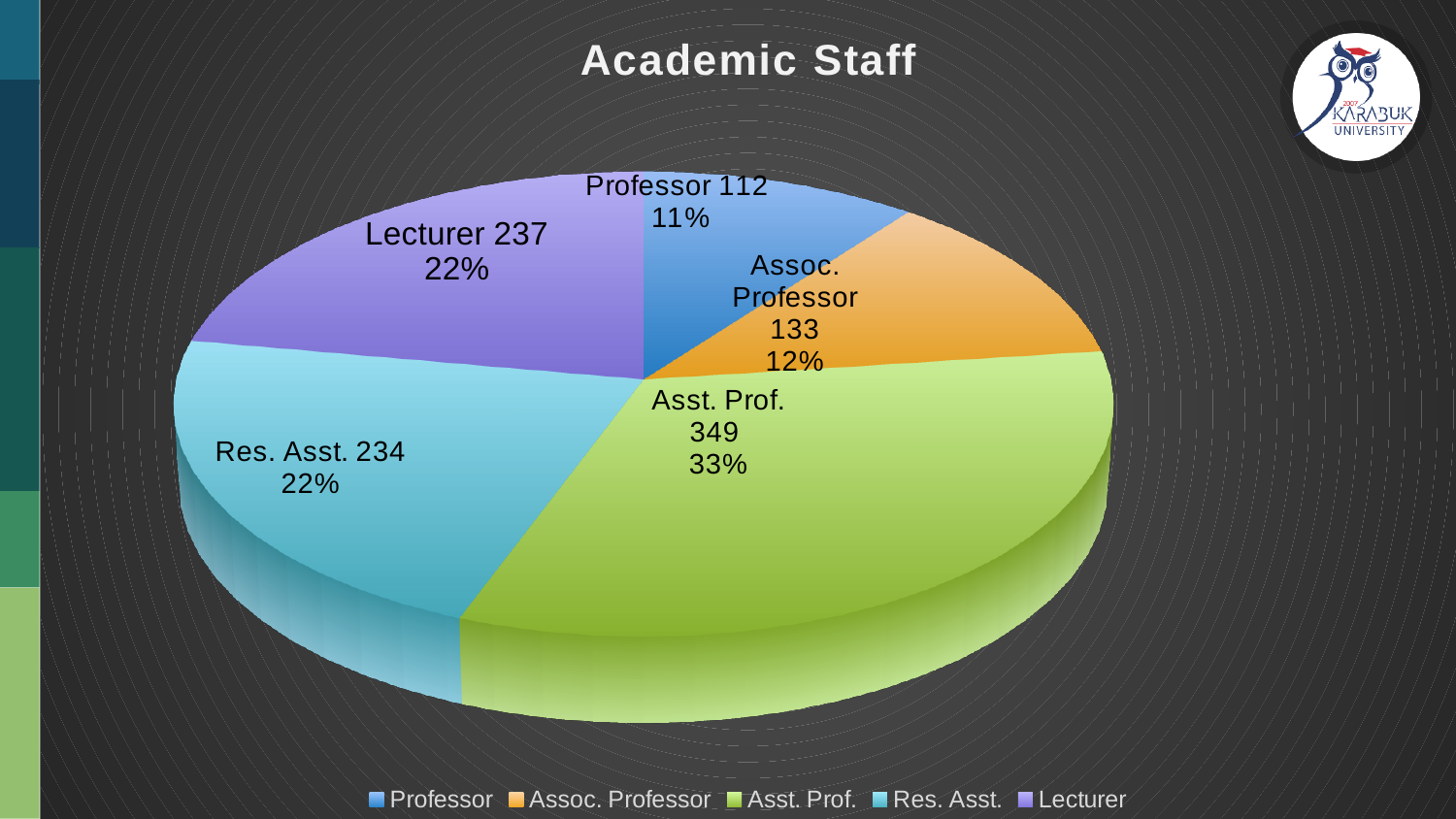
What is the difference between the Asst. Prof. value and the Professor value in the Academic Staff chart? 237 Which category has the largest slice in the Academic Staff pie chart? Asst. Prof. Which is larger in the Academic Staff chart, Lecturer or Res. Asst.? Lecturer How many categories are shown in the Academic Staff pie chart? 5 What kind of chart is shown on the slide? Pie chart What percentage share does Res. Asst. have in the Academic Staff pie chart? 22% What is the value for Professor in the Academic Staff pie chart? 112 What is the value for Lecturer in the Academic Staff pie chart? 237 What is the value for Asst. Prof. in the Academic Staff pie chart? 349 What is the title of the chart on the slide? Academic Staff What percentage share does Assoc. Professor have in the Academic Staff pie chart? 12% Which category has the smallest slice in the Academic Staff pie chart? Professor